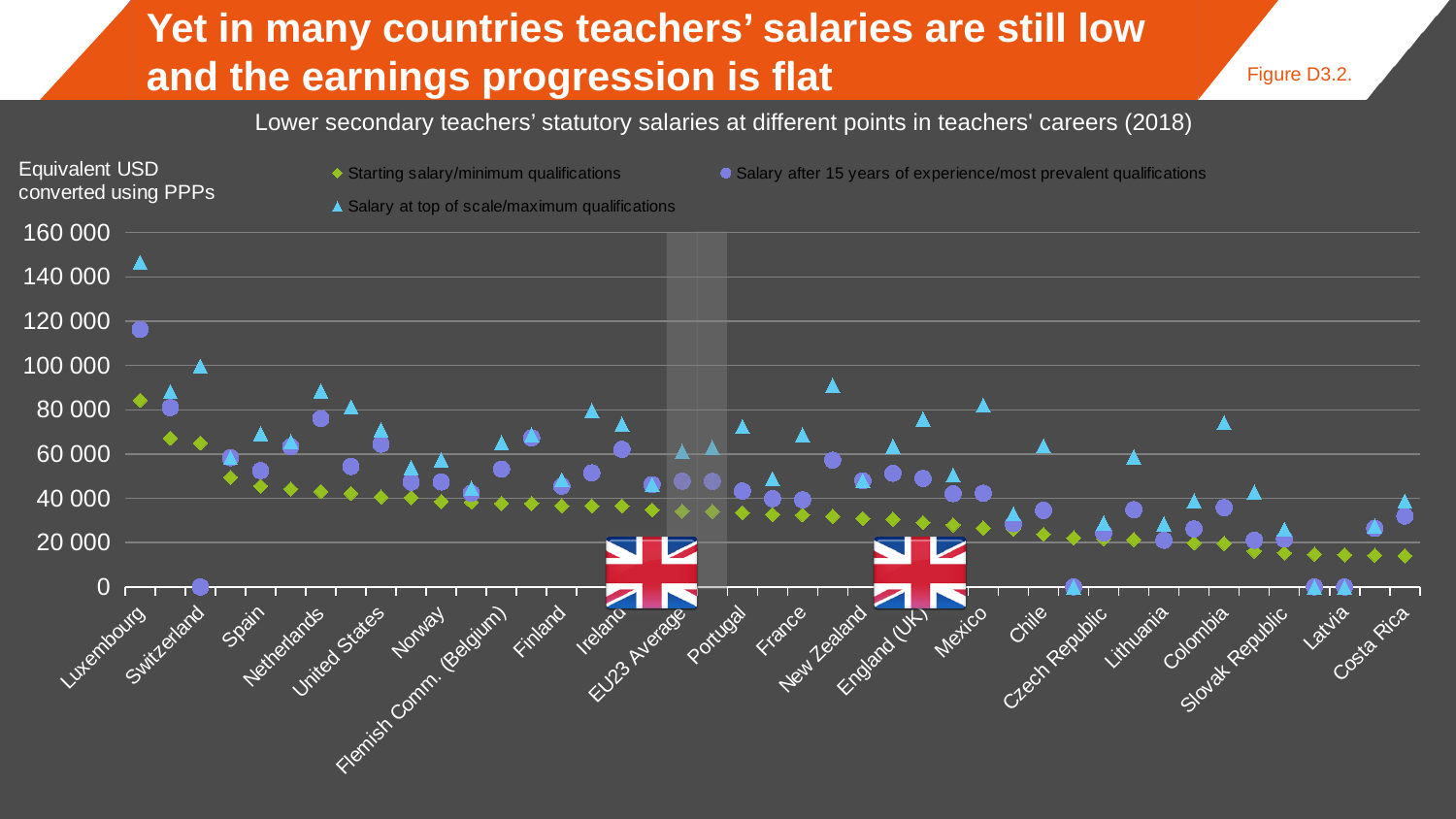
Is the salary after 15 years of experience/most prevalent qualifications for Luxembourg greater or less than 120 000? less Is the salary at top of scale/maximum qualifications for New Zealand greater or less than 80 000? less What kind of chart is shown on the slide? scatter chart Is the starting salary/minimum qualifications for Spain greater or less than 40 000? greater Which has the larger starting salary/minimum qualifications, Luxembourg or Switzerland? Luxembourg Which country has the highest starting salary/minimum qualifications? Luxembourg Which country has the highest salary at top of scale/maximum qualifications? Luxembourg What is the label on the vertical axis of the chart? Equivalent USD converted using PPPs How many series does the chart legend list? 3 Do the salary values generally rise or fall moving from left to right along the x axis? fall